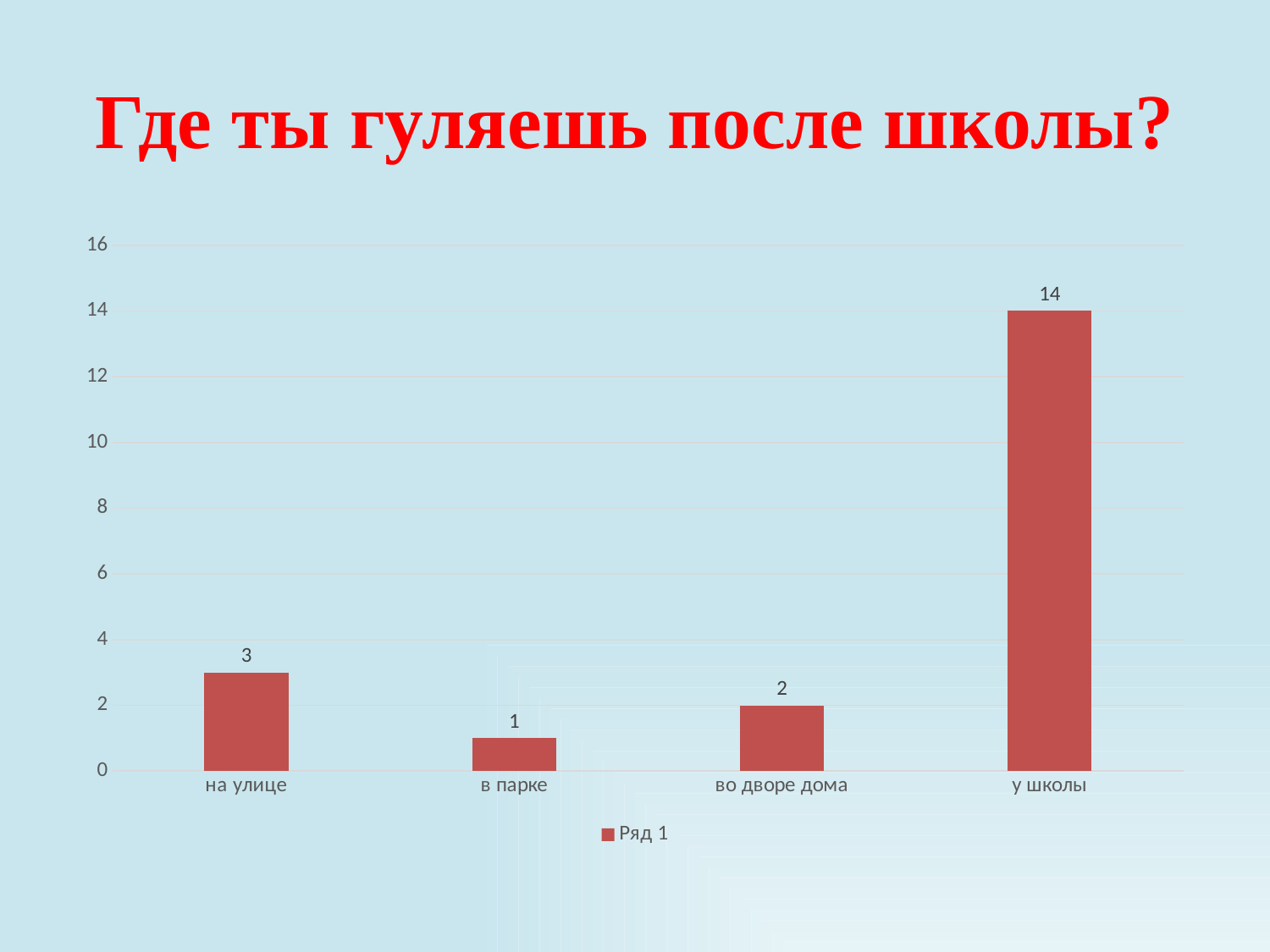
Which category has the highest value? у школы Is the value for "у школы" greater or less than 10? greater What is the value for "в парке"? 1 What kind of chart is shown on the slide? bar chart What is the value for "на улице"? 3 What is the difference between the values for "у школы" and "на улице"? 11 Which category has the lowest value? в парке What is the value for "во дворе дома"? 2 What is the value for "у школы"? 14 How many categories are shown on the x axis? 4 What is the name of the series listed in the legend? Ряд 1 Which is larger, the value for "на улице" or the value for "во дворе дома"? на улице